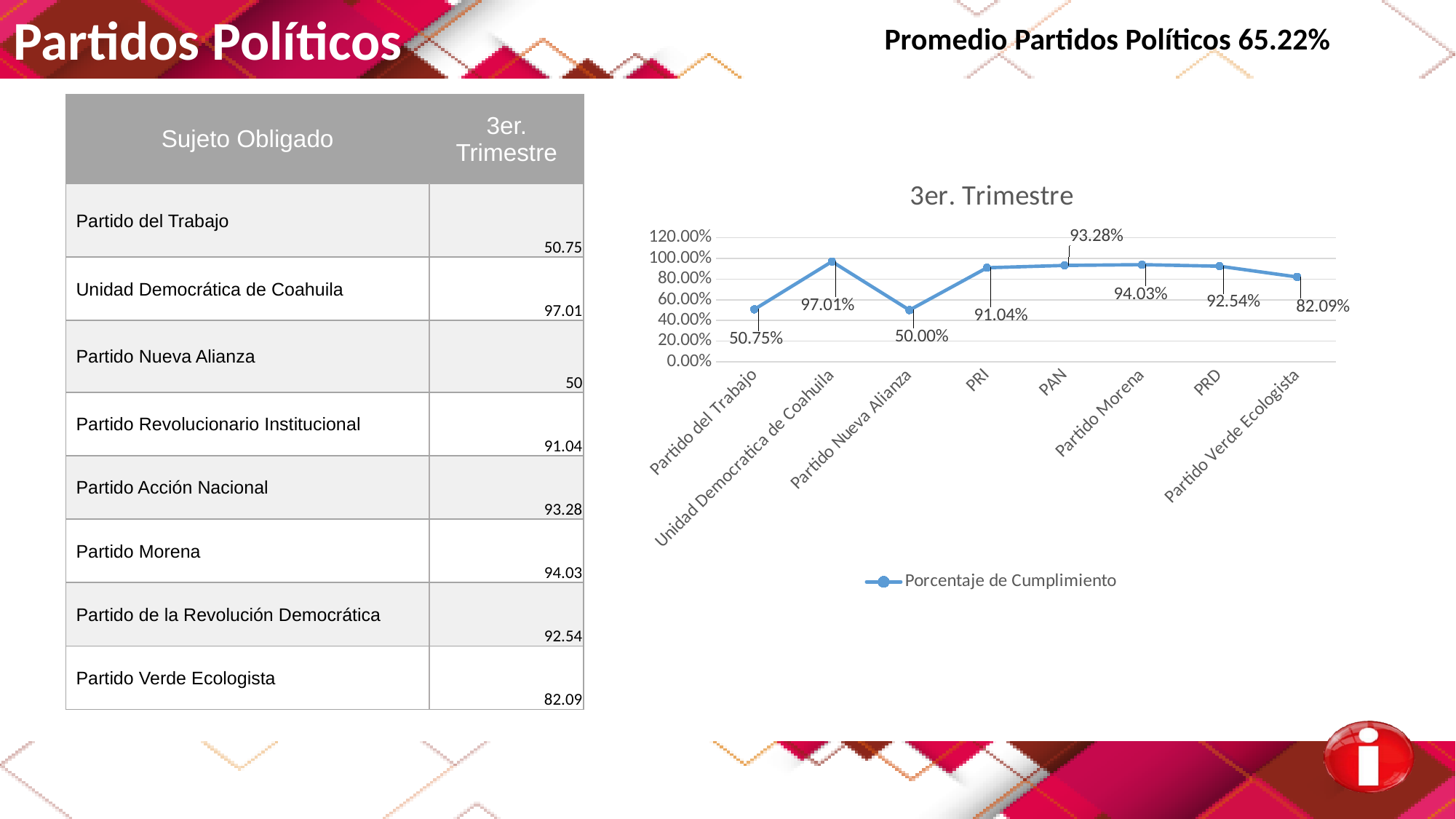
What is the difference between the values for PAN and PRI? 2.24% Is the value for Partido del Trabajo greater or less than 60.00%? less What kind of chart is shown on the slide? line chart What is the difference between the values for Unidad Democratica de Coahuila and Partido Nueva Alianza? 47.01% What is the value for PRI in the 3er. Trimestre chart? 91.04% What is the value for Partido Morena in the chart? 94.03% Which category has the lowest value in the chart? Partido Nueva Alianza Which is larger, the value for PRD or the value for Partido Verde Ecologista? PRD Which category has the highest value in the chart? Unidad Democratica de Coahuila How many series does the chart legend list? 1 How many categories are plotted on the x axis of the chart? 8 What is the value for Partido Verde Ecologista in the chart? 82.09%